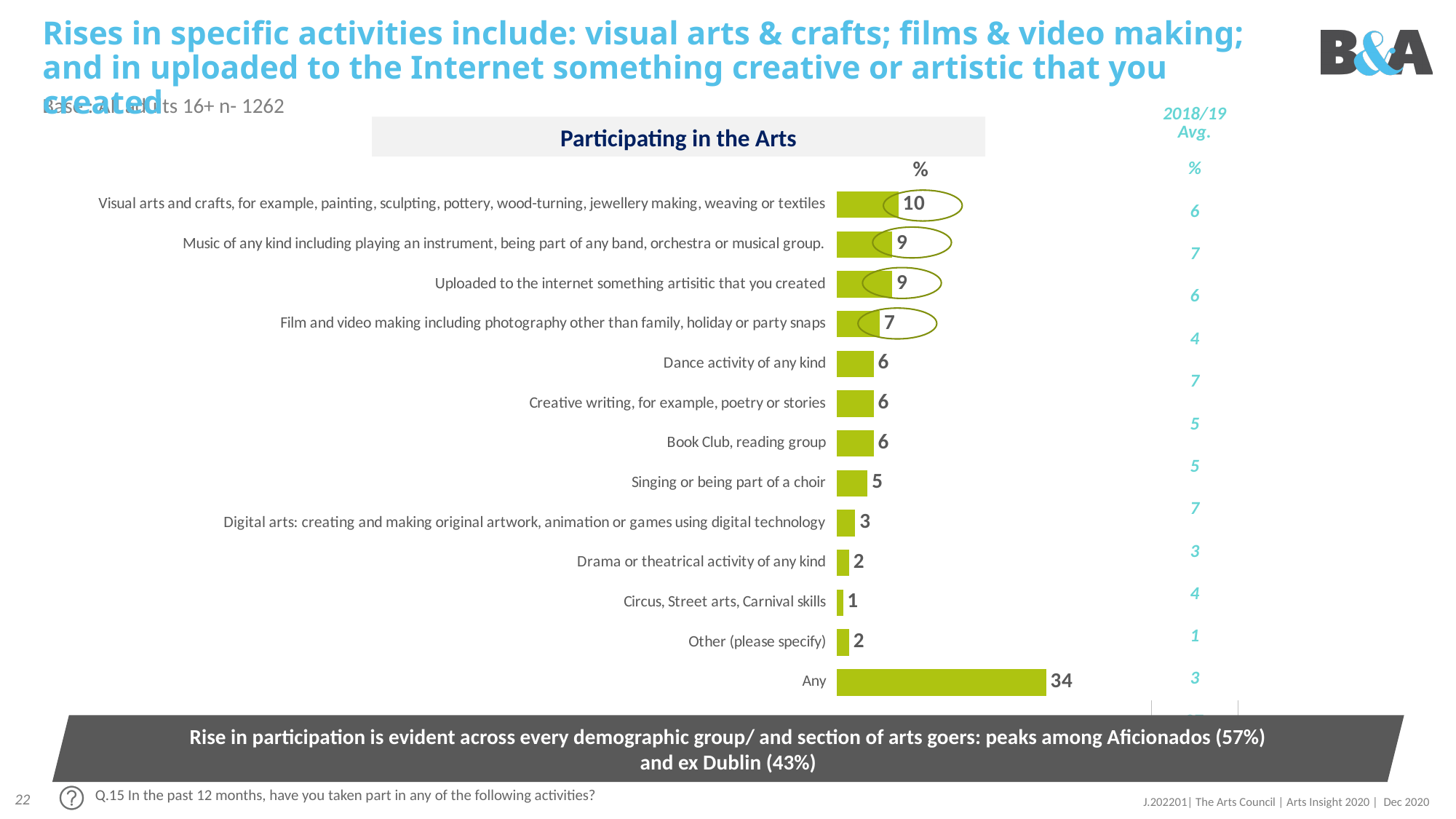
Which category has the lowest value in the chart? Circus, Street arts, Carnival skills What is the value for 'Drama or theatrical activity of any kind'? 2 What is the difference between the value for 'Any' and the value for 'Visual arts and crafts'? 24 What kind of chart is shown on the slide? Bar chart Which category has the highest value in the chart? Any What is the value for 'Film and video making including photography other than family, holiday or party snaps'? 7 What is the difference between the value for 'Visual arts and crafts' and the value for 'Film and video making'? 3 Which is larger: the value for 'Singing or being part of a choir' or the value for 'Digital arts: creating and making original artwork, animation or games using digital technology'? Singing or being part of a choir What is the value for 'Any'? 34 How many categories are shown in the chart? 13 What is the value for 'Visual arts and crafts, for example, painting, sculpting, pottery, wood-turning, jewellery making, weaving or textiles'? 10 What is the title of the chart? Participating in the Arts